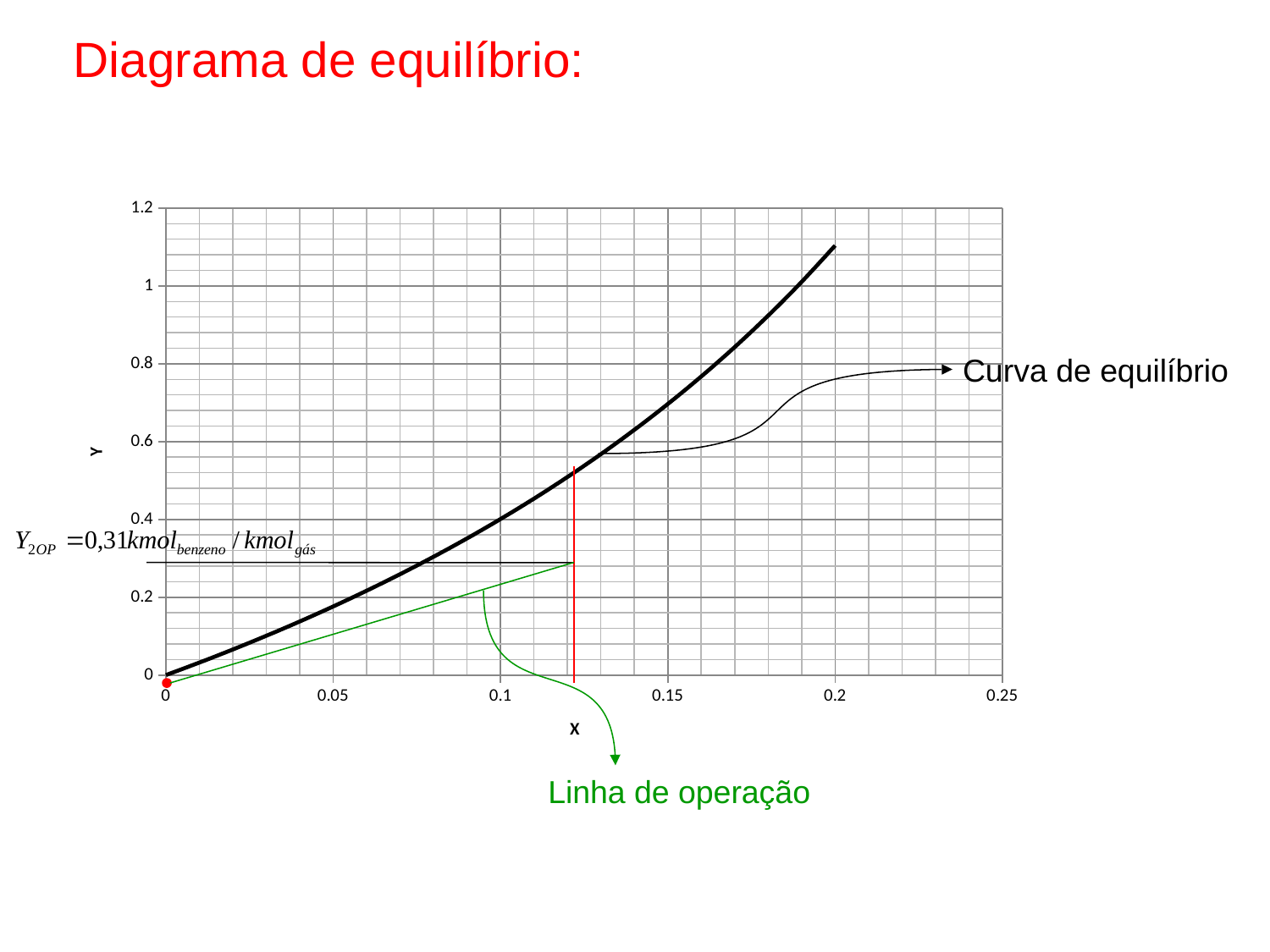
Does the equilibrium curve (Curva de equilíbrio) rise or fall as X increases? rise Is the value of the equilibrium curve at X = 0.15 greater or less than 0.6? greater What value of Y_2OP is printed on the slide? 0,31 kmol benzeno / kmol gás Is the value of the equilibrium curve at X = 0.05 greater or less than 0.4? less Is the value of the equilibrium curve at X = 0.2 greater or less than 1? greater At X = 0.1, which is higher: the equilibrium curve or the operating line (Linha de operação)? the equilibrium curve What is the title of the slide containing the chart? Diagrama de equilíbrio: What kind of chart is shown on the slide? line chart What label is given to the green line on the chart? Linha de operação